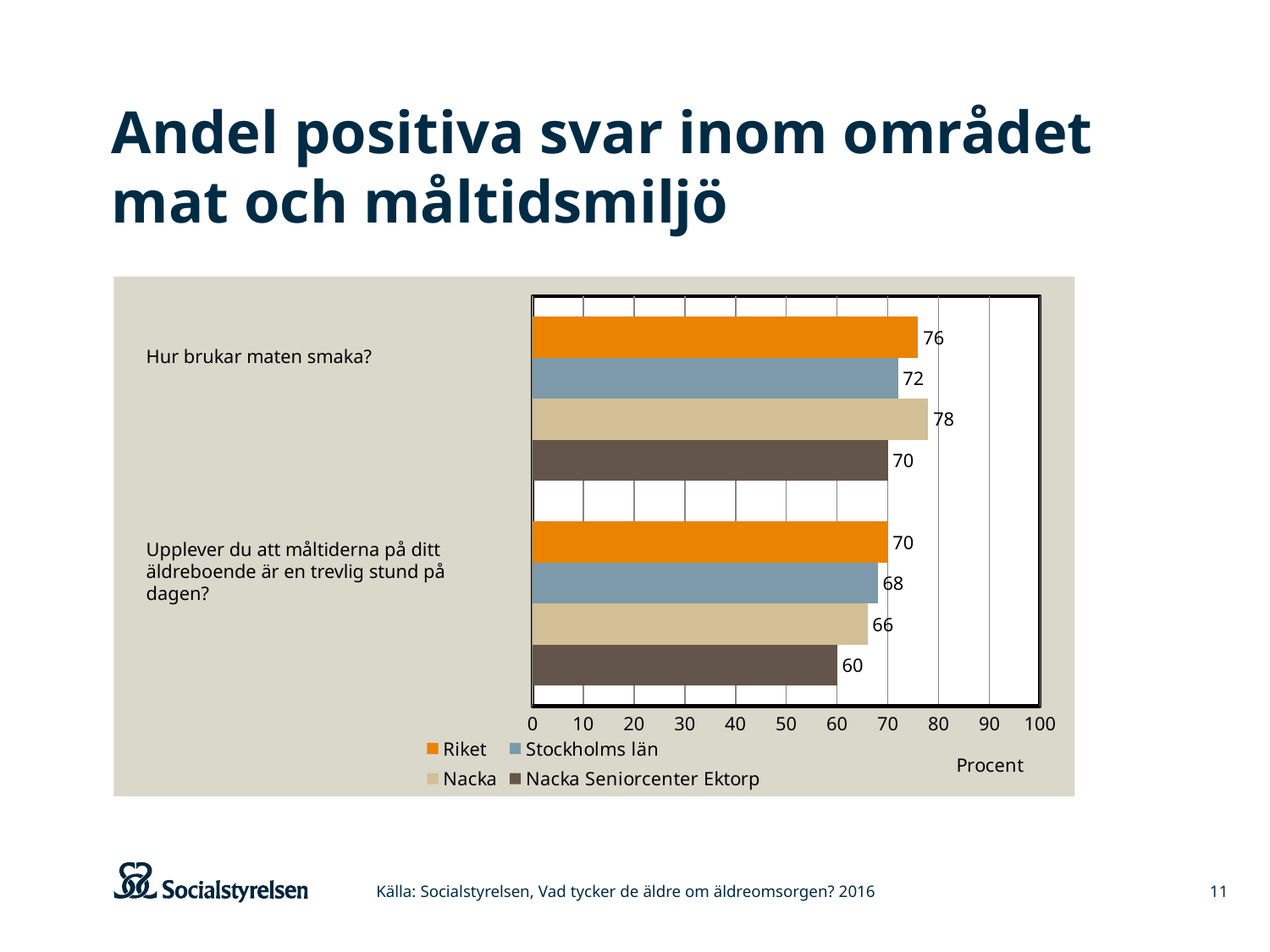
How many series does the legend list? 4 What kind of chart is shown on the slide? Bar chart Which series has the lowest value for "Upplever du att måltiderna på ditt äldreboende är en trevlig stund på dagen?"? Nacka Seniorcenter Ektorp What is the difference between the Riket values for the two questions? 6 Which series has the highest value for "Hur brukar maten smaka?"? Nacka What is the value for Riket for "Hur brukar maten smaka?"? 76 How many question categories are shown on the chart? 2 What is the label on the horizontal axis of the chart? Procent What is the value for Stockholms län for "Hur brukar maten smaka?"? 72 What is the value for Nacka Seniorcenter Ektorp for "Upplever du att måltiderna på ditt äldreboende är en trevlig stund på dagen?"? 60 Which is larger for "Upplever du att måltiderna på ditt äldreboende är en trevlig stund på dagen?": Riket or Nacka? Riket What is the difference between the Nacka and Nacka Seniorcenter Ektorp values for "Hur brukar maten smaka?"? 8